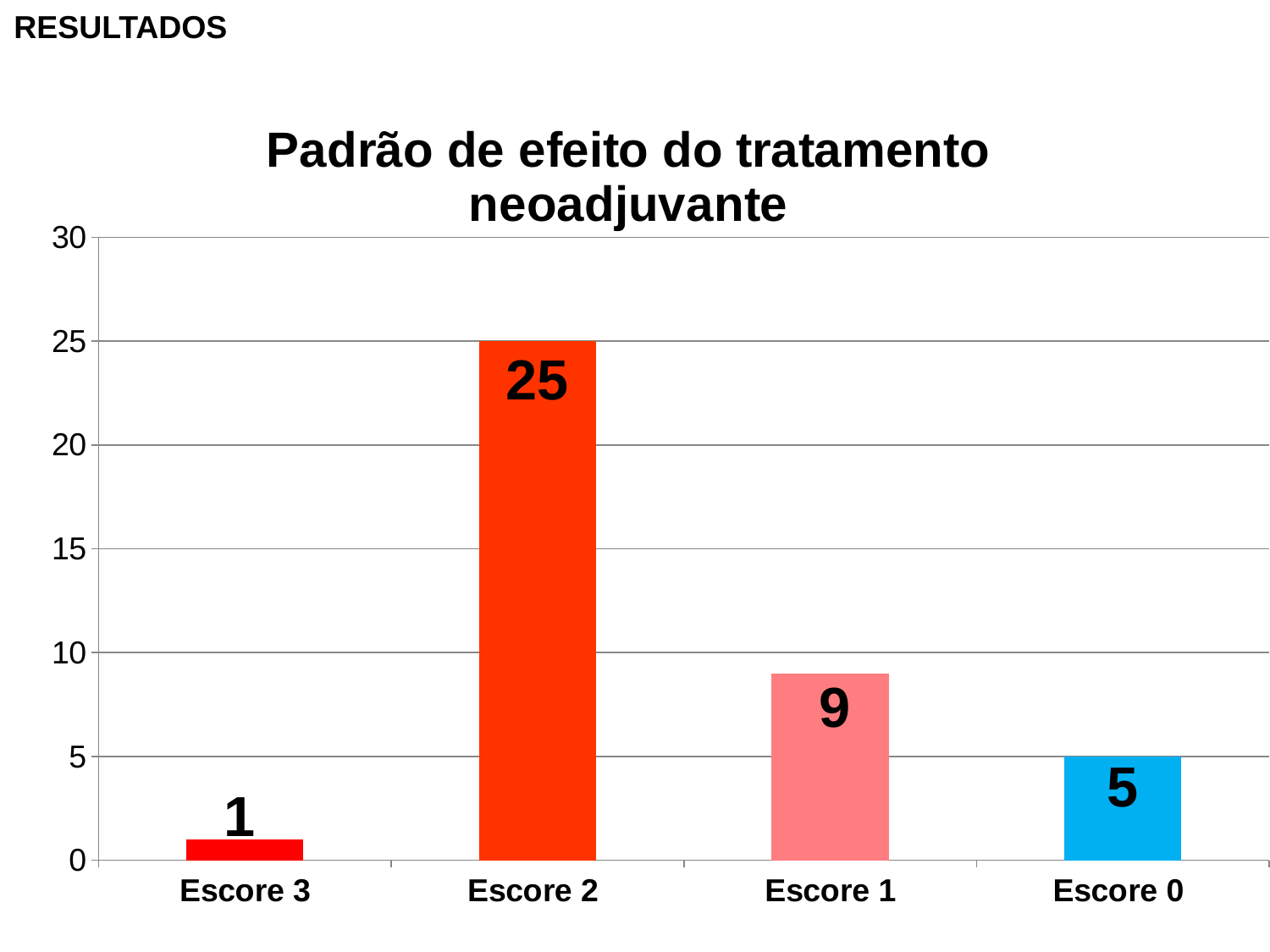
How many categories are shown on the x axis? 4 Which category has the lowest value? Escore 3 What is the value for Escore 0? 5 What is the value for Escore 3? 1 What is the value for Escore 1? 9 Which category has the highest value? Escore 2 What kind of chart is shown on the slide? bar chart Which is larger, the value for Escore 1 or the value for Escore 0? Escore 1 Is the value for Escore 2 greater or less than 20? greater What is the value for Escore 2? 25 What is the difference between the values for Escore 2 and Escore 1? 16 What is the title of the chart? Padrão de efeito do tratamento neoadjuvante